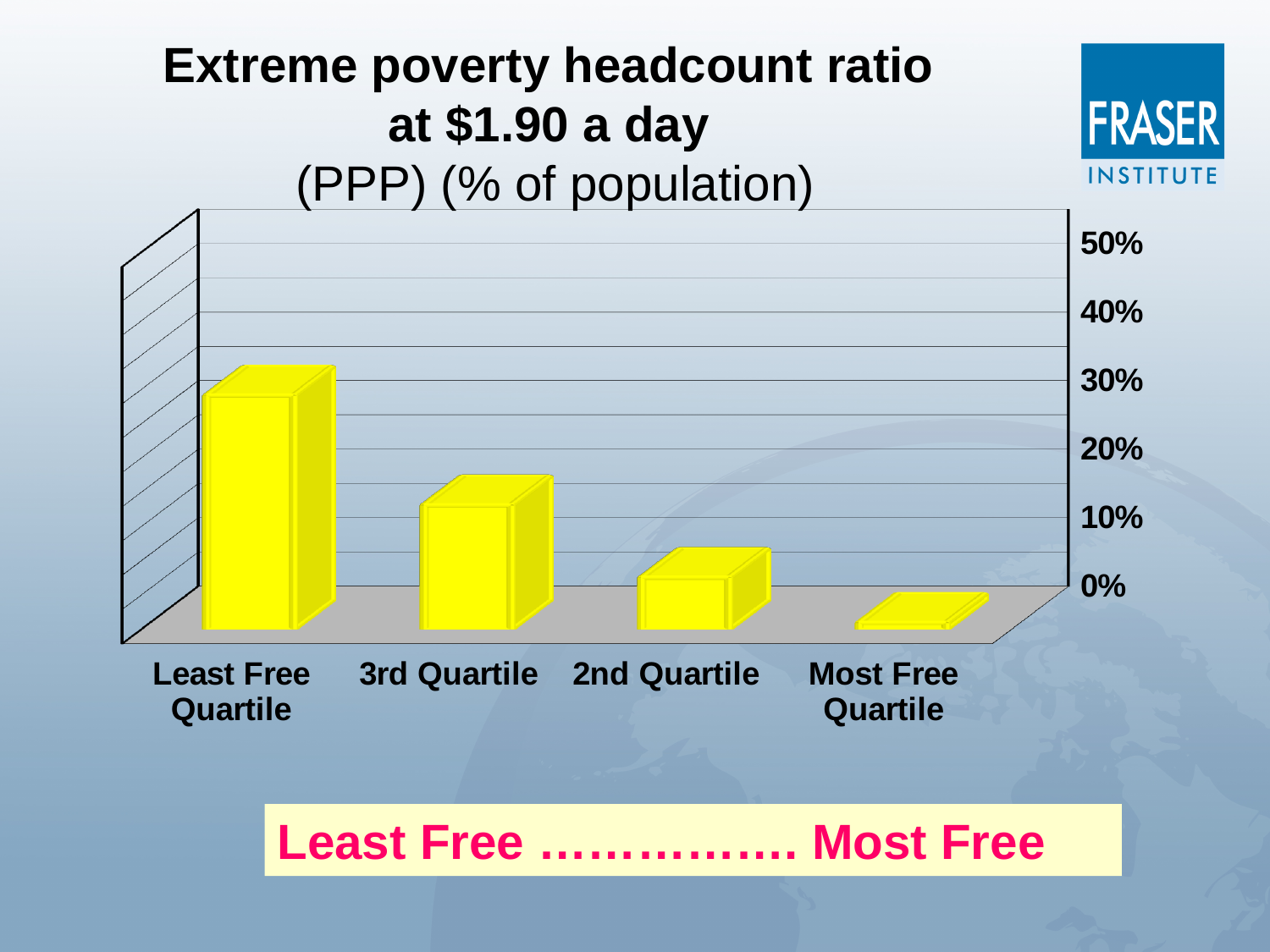
How many quartile categories are plotted in the chart? 4 What kind of chart is shown on the slide? bar chart Which quartile has the lowest extreme poverty headcount ratio? Most Free Quartile Is the value for the Least Free Quartile greater or less than 20%? greater Is the value for the Most Free Quartile greater or less than 10%? less Is the value for the 3rd Quartile greater or less than 30%? less Which quartile has the highest extreme poverty headcount ratio? Least Free Quartile What is the title of the chart? Extreme poverty headcount ratio at $1.90 a day (PPP) (% of population) Which is larger, the value for the 3rd Quartile or the value for the 2nd Quartile? 3rd Quartile Do the values rise or fall moving from the Least Free Quartile to the Most Free Quartile along the x axis? fall